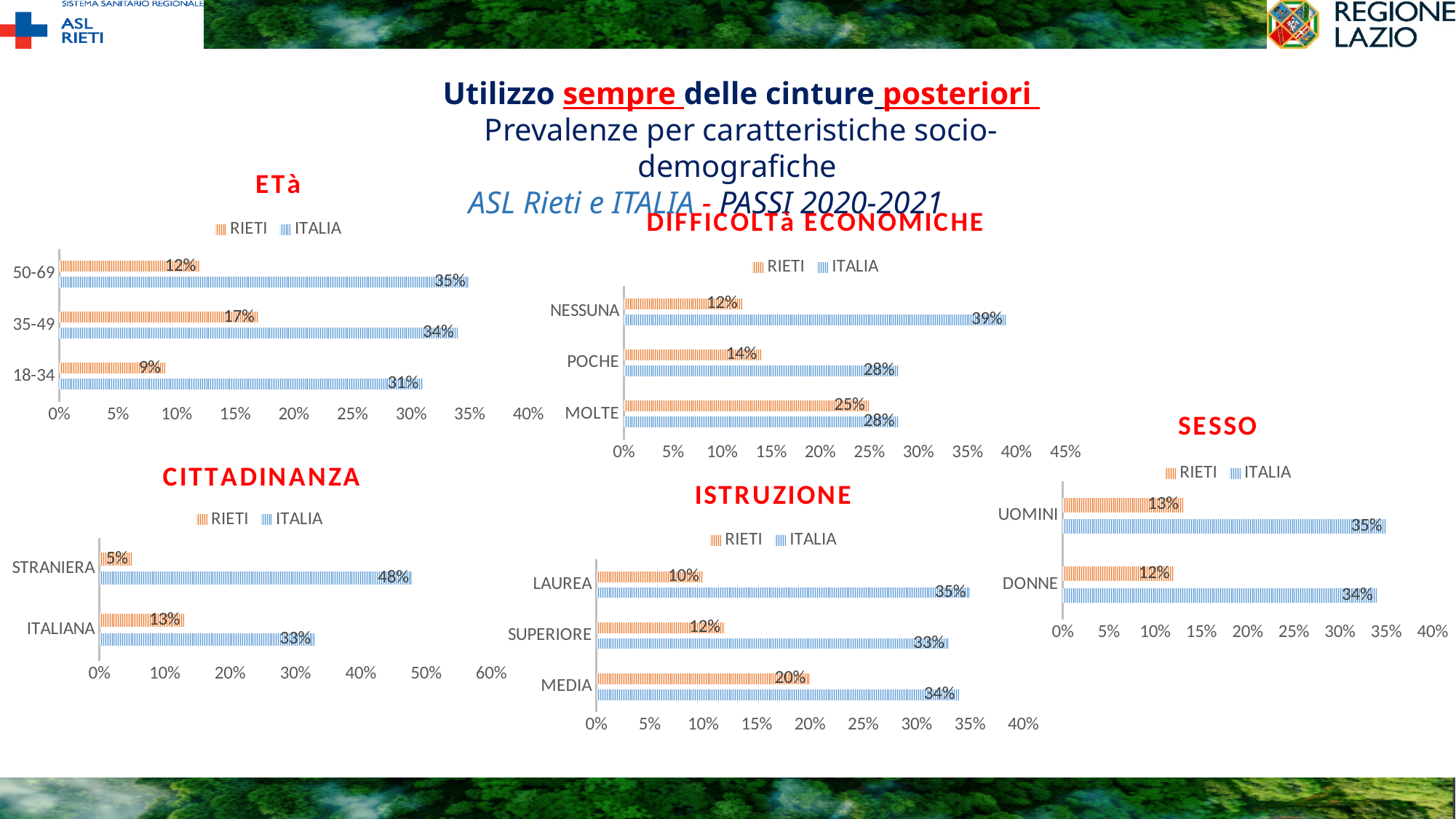
In the ISTRUZIONE chart, what is the RIETI value for MEDIA? 20% How many series does the legend of the SESSO chart list? 2 What type of chart is the CITTADINANZA chart? bar chart In the DIFFICOLTà ECONOMICHE chart, what is the ITALIA value for NESSUNA? 39% In the ETà chart, what is the RIETI value for the 35-49 age group? 17% In the SESSO chart, what is the ITALIA value for UOMINI? 35% In the ISTRUZIONE chart, how many education categories are shown? 3 In the DIFFICOLTà ECONOMICHE chart, what is the difference between the ITALIA and RIETI values for NESSUNA? 27% In the CITTADINANZA chart, what is the ITALIA value for STRANIERA? 48% In the CITTADINANZA chart, is the RIETI value for ITALIANA larger or smaller than the RIETI value for STRANIERA? larger In the ETà chart, which age group has the lowest RIETI value? 18-34 In the DIFFICOLTà ECONOMICHE chart, which category has the highest RIETI value? MOLTE